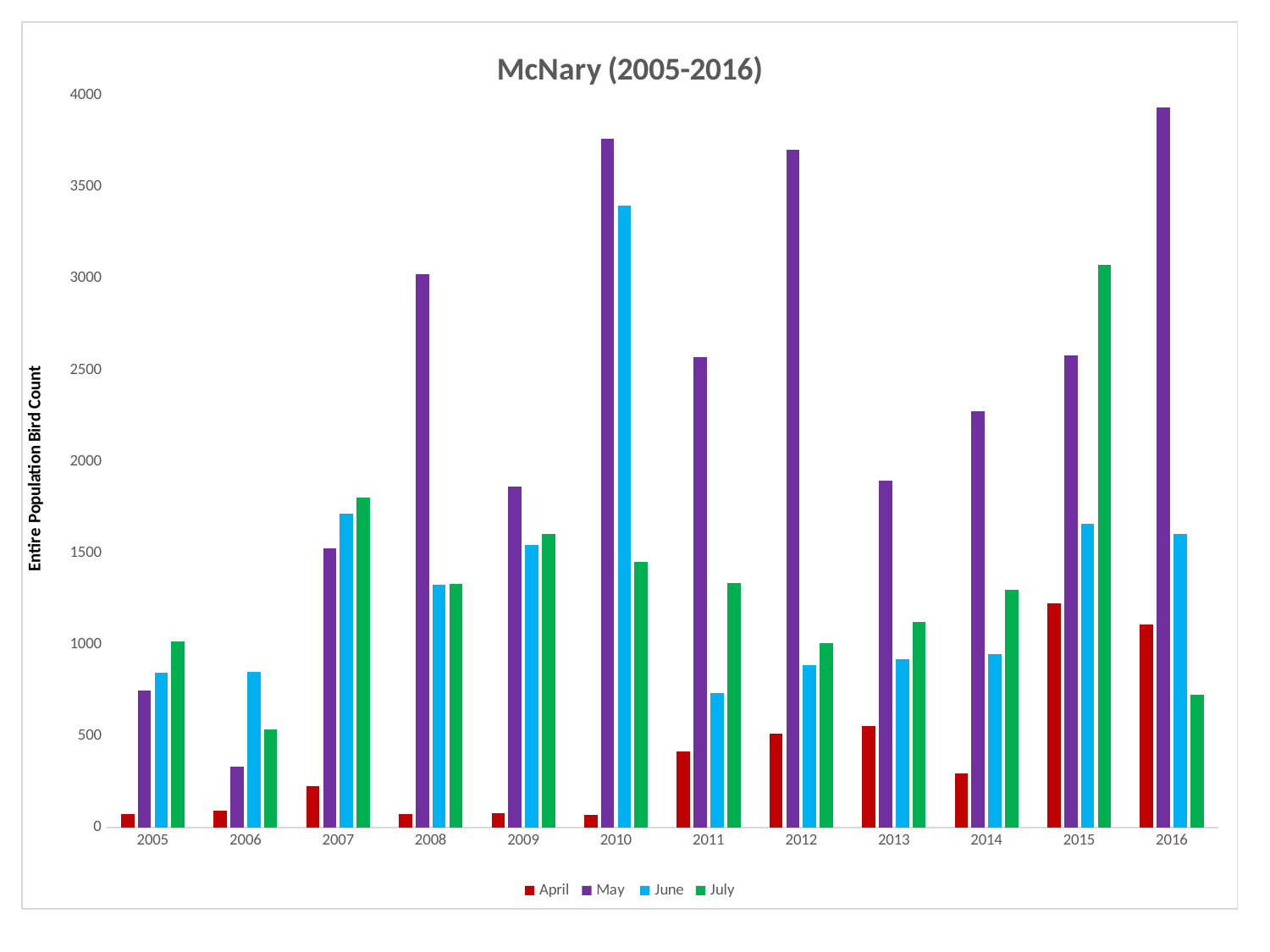
In 2008, which is larger, the May count or the June count? May How many series does the legend list? 4 Is the June value for 2011 greater or less than 1000? less What is the title of the y axis? Entire Population Bird Count In which year is the May bird count lowest? 2006 Is the July value for 2015 greater or less than 2500? greater In which year is the April bird count highest? 2015 How many years are shown along the x axis? 12 In which year is the May bird count highest? 2016 What kind of chart is shown on the slide? bar chart Is the May value for 2010 greater or less than 3500? greater In 2015, which is larger, the May count or the July count? July